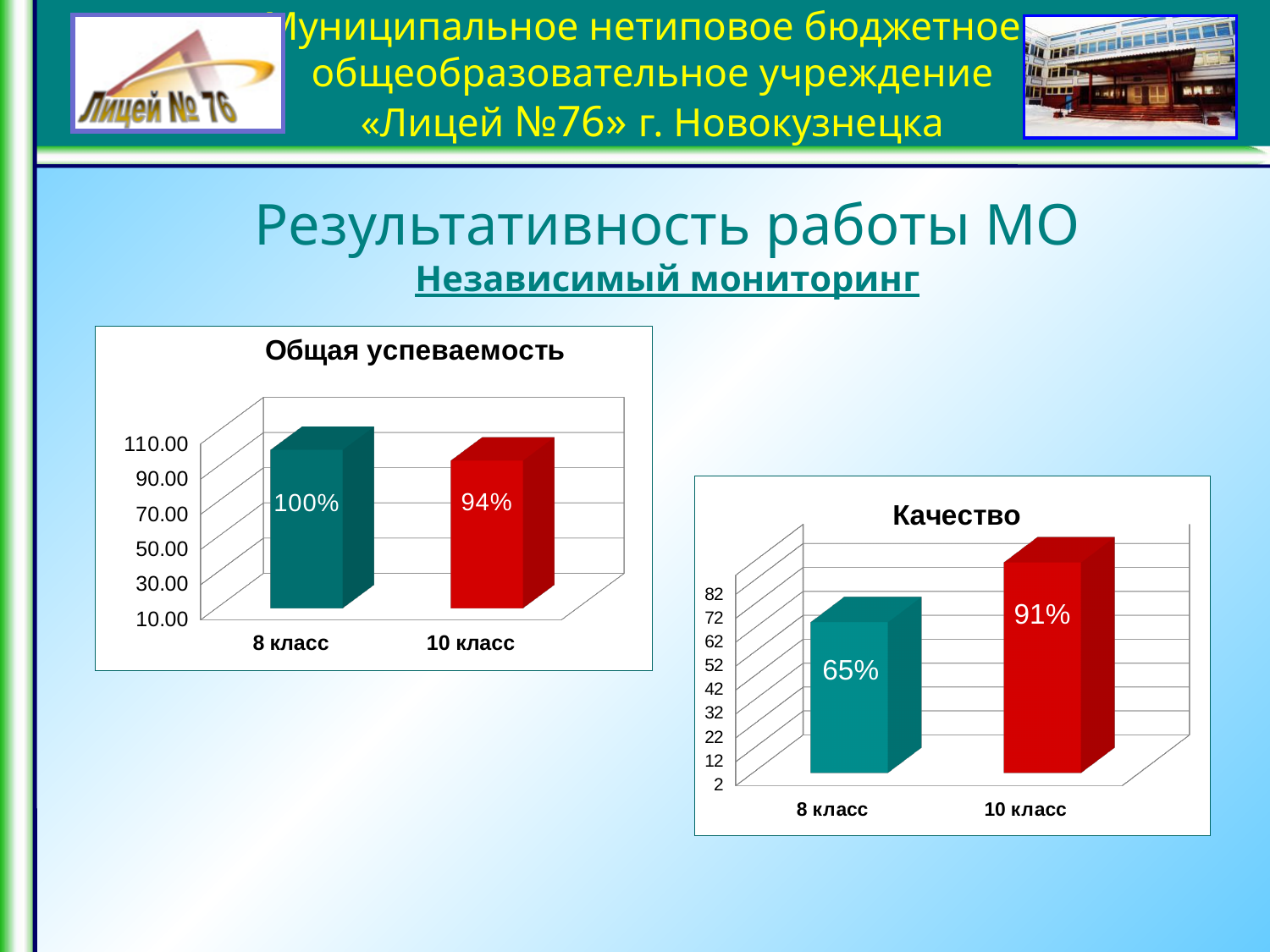
In the "Качество" chart, what is the difference between the values for 10 класс and 8 класс? 26% In the "Общая успеваемость" chart, which is larger: the value for 8 класс or 10 класс? 8 класс How many categories are shown in the "Качество" chart? 2 In the "Общая успеваемость" chart, what is the value for 8 класс? 100% In the "Качество" chart, what is the value for 10 класс? 91% In the "Качество" chart, which category has the highest value? 10 класс What kind of chart is the "Качество" chart? Bar chart In the "Общая успеваемость" chart, what is the difference between the values for 8 класс and 10 класс? 6% In the "Общая успеваемость" chart, what is the value for 10 класс? 94% In the "Качество" chart, what is the value for 8 класс? 65% In the "Общая успеваемость" chart, which category has the lowest value? 10 класс In the "Качество" chart, do the values rise or fall from 8 класс to 10 класс? Rise